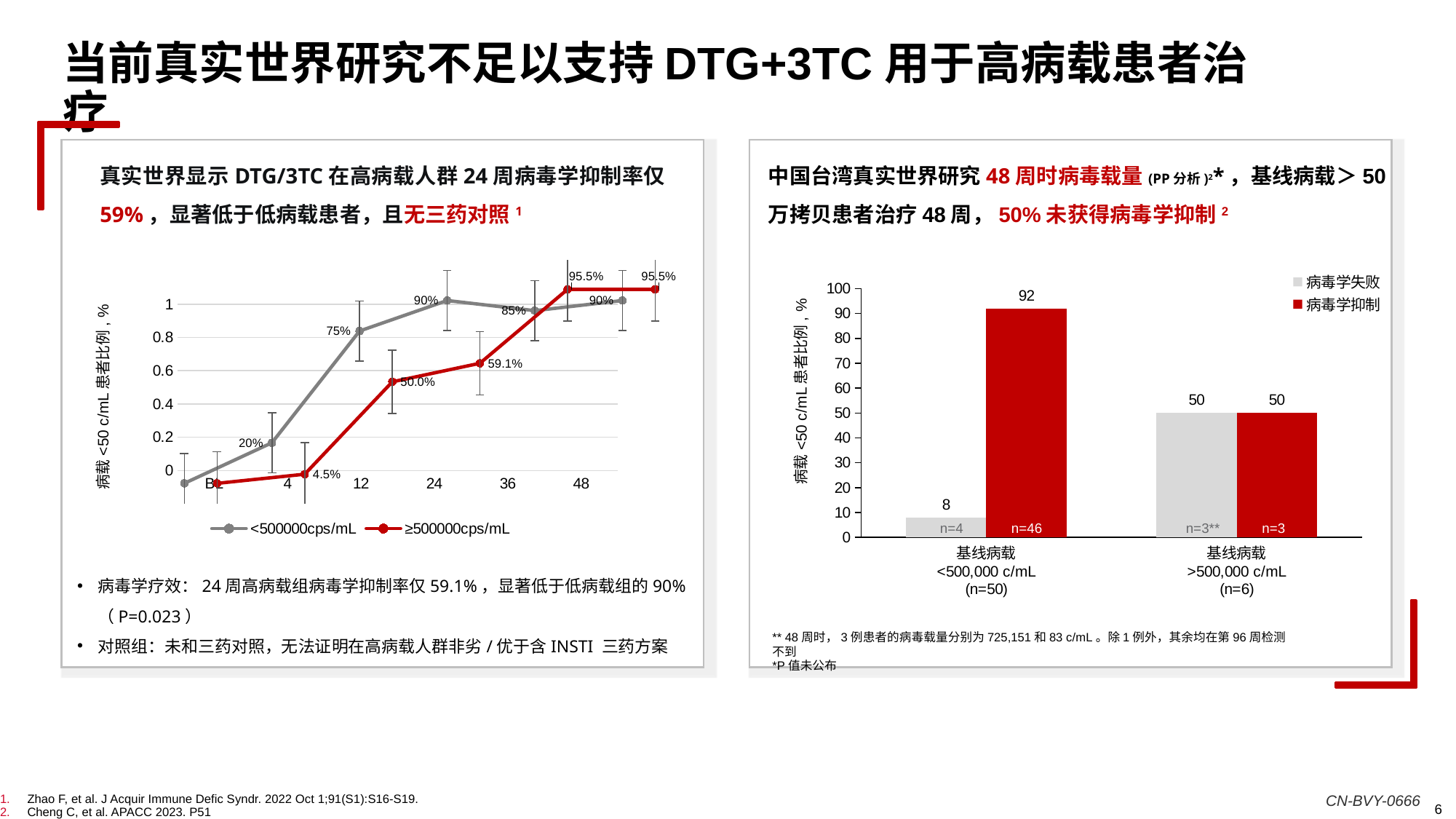
In the right-hand bar chart, what is the difference between 病毒学抑制 and 病毒学失败 for the 基线病载 <500,000 c/mL (n=50) group? 84 In the right-hand bar chart, which bar is the tallest? 病毒学抑制 for 基线病载 <500,000 c/mL (n=50) In the right-hand bar chart, what is the value of 病毒学失败 for the 基线病载 <500,000 c/mL (n=50) group? 8 In the right-hand bar chart, how many baseline viral load groups are shown on the x axis? 2 In the left-hand line chart, how many series does the legend list? 2 In the right-hand bar chart, how many series does the legend list? 2 In the right-hand bar chart, what is the value of 病毒学抑制 for the 基线病载 <500,000 c/mL (n=50) group? 92 In the left-hand line chart, which series has the higher value at week 12, <500000cps/mL or ≥500000cps/mL? <500000cps/mL In the left-hand line chart, what is the labelled value of the ≥500000cps/mL series at week 24? 59.1% In the right-hand bar chart, what is the value of 病毒学抑制 for the 基线病载 >500,000 c/mL (n=6) group? 50 What kind of chart is the chart on the right side of the slide? bar chart What kind of chart is the chart on the left side of the slide? line chart